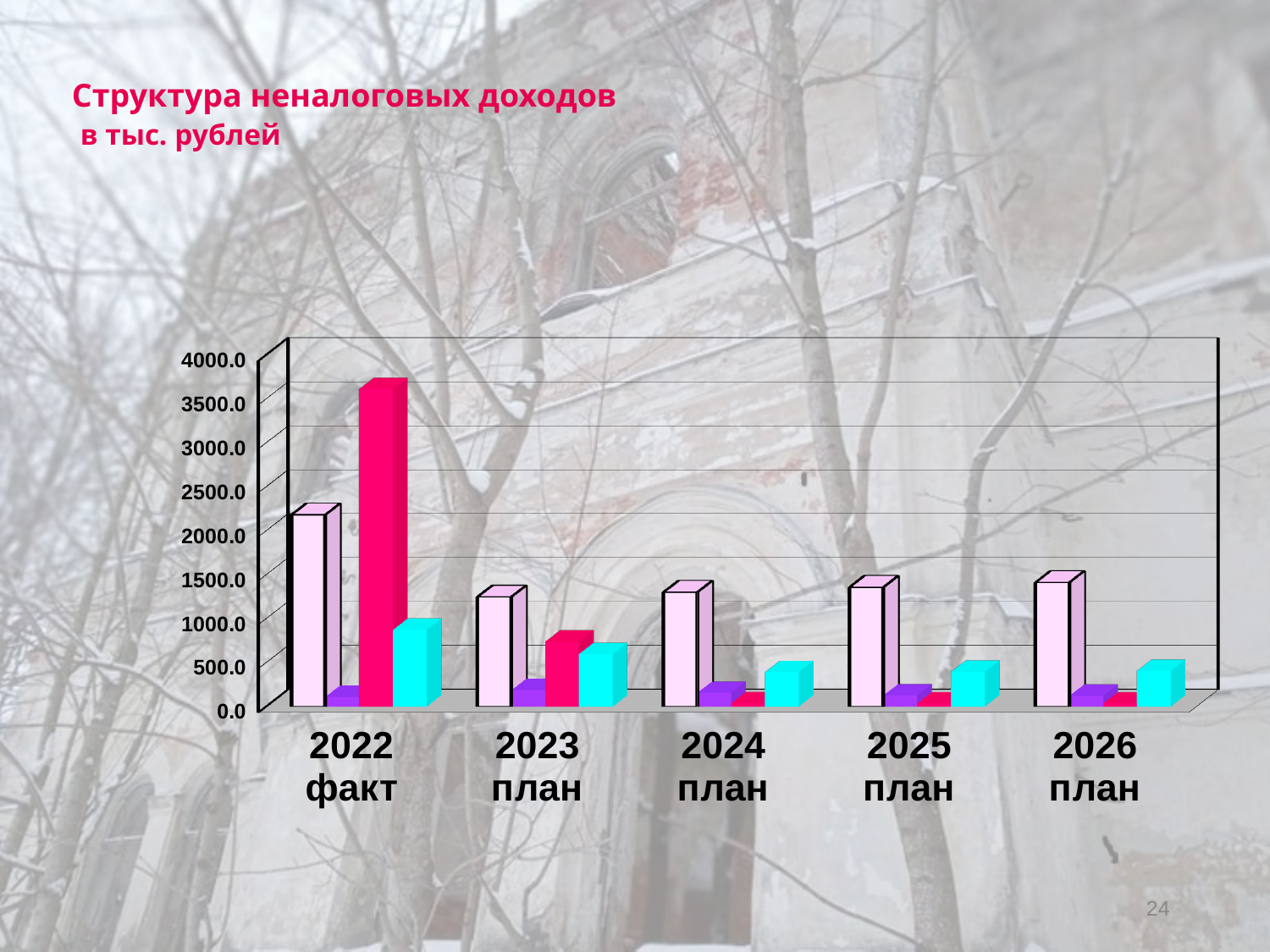
For 2022 факт, which is larger: the magenta bar or the light pink bar? the magenta bar For 2023 план, which is larger: the light pink bar or the magenta bar? the light pink bar Which category contains the tallest bar in the chart? 2022 факт How many bars are plotted for each category in the chart? 4 What is the title of the chart on the slide? Структура неналоговых доходов в тыс. рублей What kind of chart is shown on the slide? bar chart Is the value of the purple bar for 2023 план greater or less than 500.0? less Is the value of the light pink bar for 2024 план greater or less than 1000.0? greater Is the value of the tallest (magenta) bar for 2022 факт greater or less than 3000.0? greater How many categories are shown along the x axis of the chart? 5 Do the values of the magenta bars rise or fall from 2022 факт to 2024 план? fall